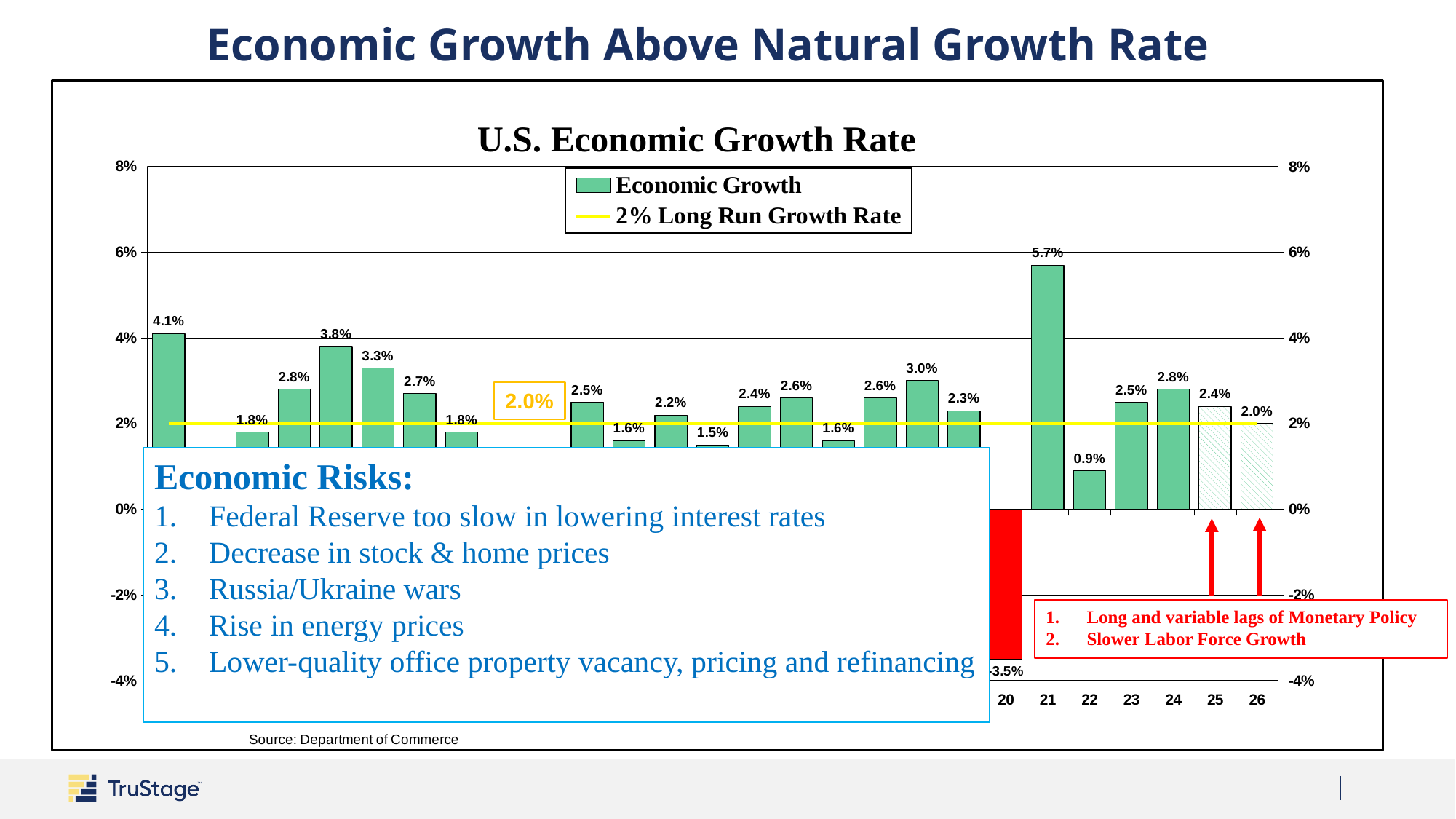
Which year has the highest economic growth rate on the chart? 21 From 24 to 26, do the growth rate values rise or fall? Fall What does the yellow line in the chart represent, according to the legend? 2% Long Run Growth Rate What is the economic growth rate shown for 20? -3.5% What is the economic growth rate shown for 24? 2.8% What kind of chart is used to show the economic growth rate? Bar chart What is the economic growth rate shown for 21? 5.7% Which year has the lowest economic growth rate on the chart? 20 How many series does the legend list? 2 What is the economic growth rate shown for 22? 0.9% What is the difference between the growth rates for 21 and 22? 4.8 percentage points Which year has the larger growth rate, 23 or 25? 23